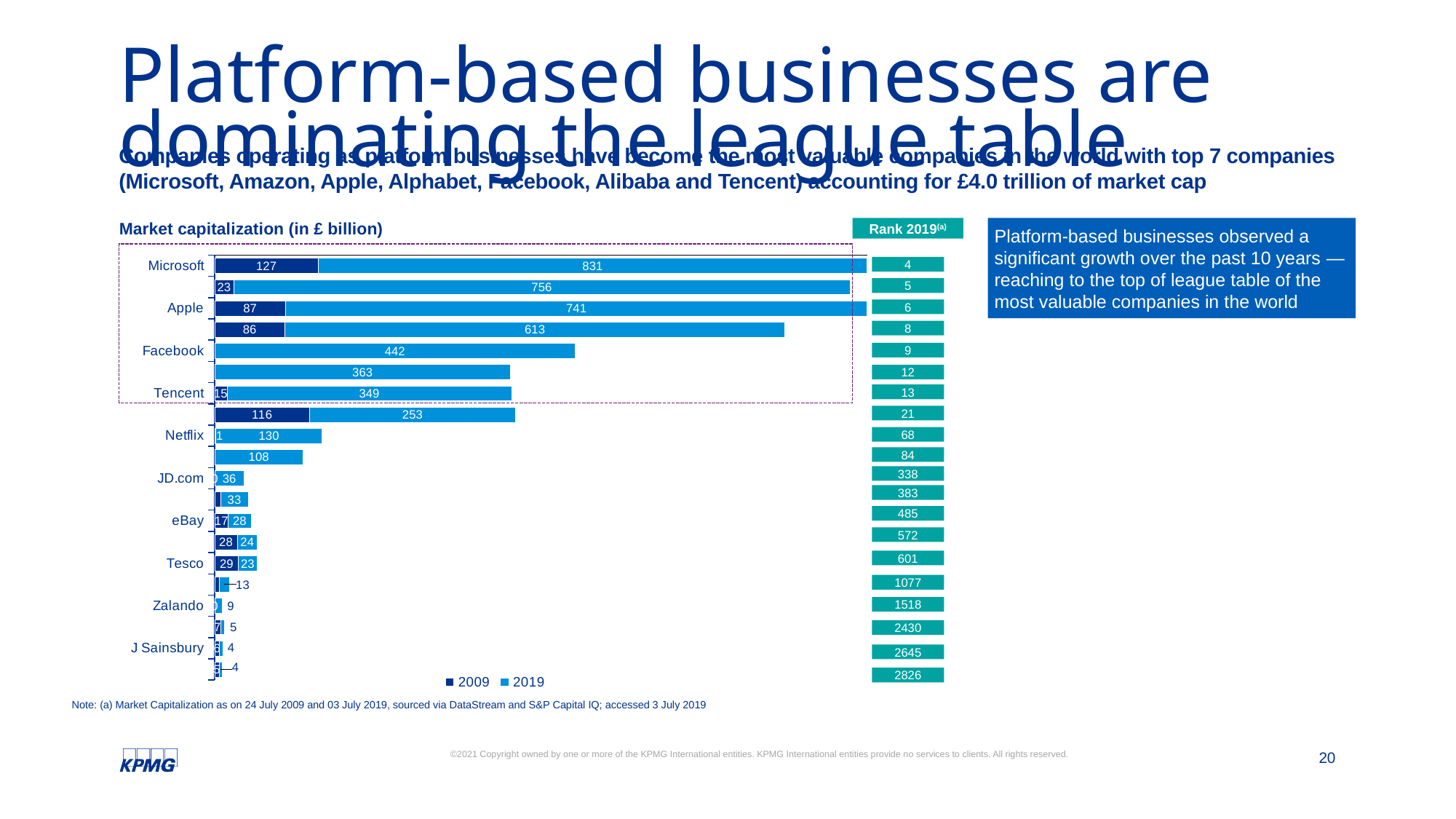
What is the difference between the 2019 market capitalization of Microsoft and Apple? 90 Which labelled company has the highest 2019 market capitalization? Microsoft For Tesco, which year has the larger market capitalization, 2009 or 2019? 2009 What kind of chart is used to show market capitalization? Bar chart How many series does the legend list? 2 What is the 2009 market capitalization for Apple? 87 What are the two entries in the chart legend? 2009 and 2019 What is the 2019 market capitalization for Netflix? 130 What is the combined 2009 and 2019 market capitalization shown for Microsoft? 958 What is the 2009 market capitalization for eBay? 17 What is the 2019 market capitalization for Microsoft? 831 What is the 2019 market capitalization for Tencent? 349